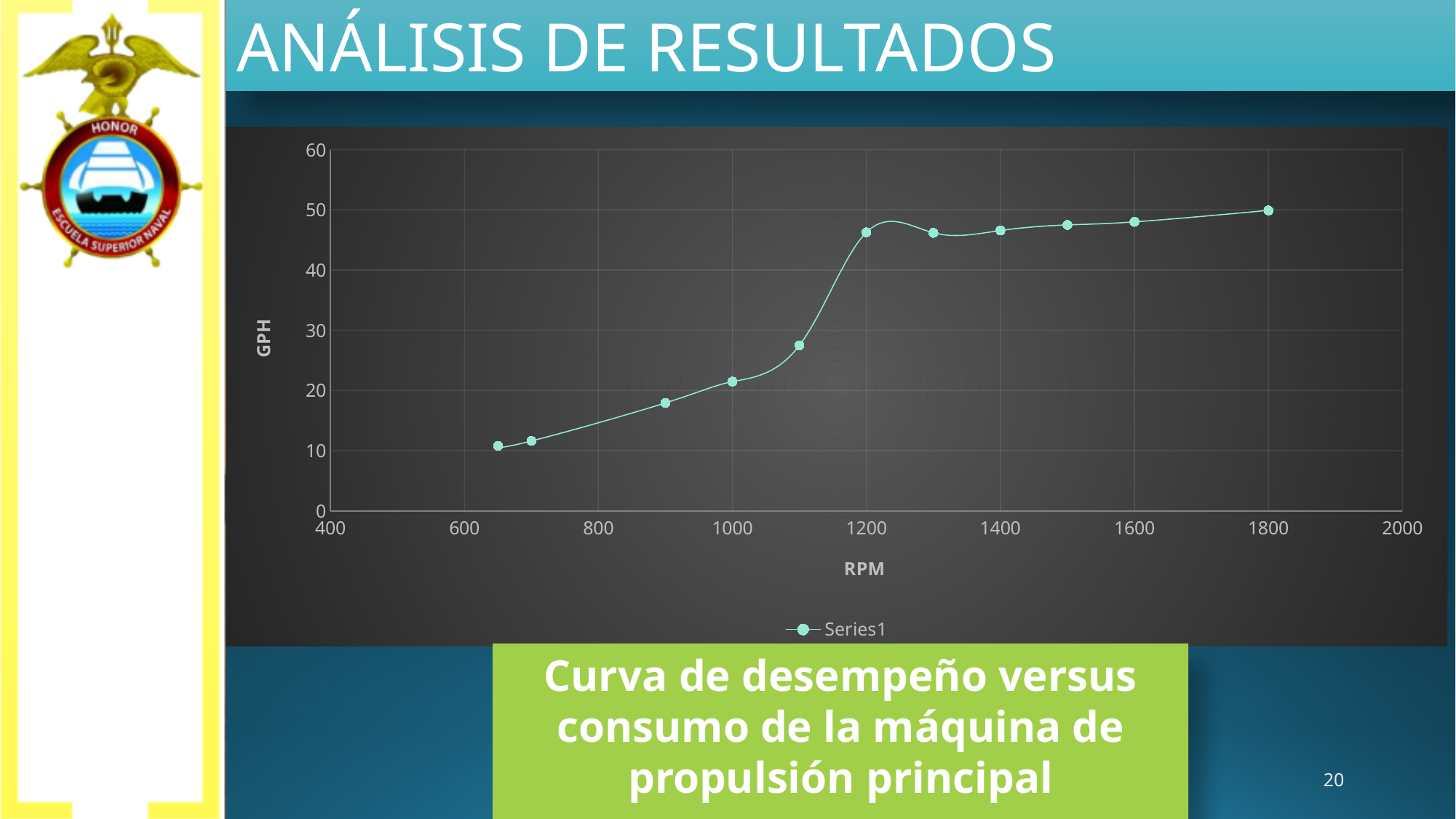
Is the GPH value at 1000 RPM greater or less than 30? less How many data points are plotted on the chart? 11 What is the label of the x axis? RPM What kind of chart is shown on the slide? line chart How many series does the legend list? 1 At which RPM value is the GPH highest? 1800 What is the label of the y axis? GPH Is the GPH value at 1800 RPM greater or less than 40? greater Is the GPH value at 1200 RPM greater or less than 40? greater Which of the two points, 1100 RPM or 1200 RPM, has the higher GPH value? 1200 RPM Do the GPH values generally rise or fall as RPM increases along the x axis? rise